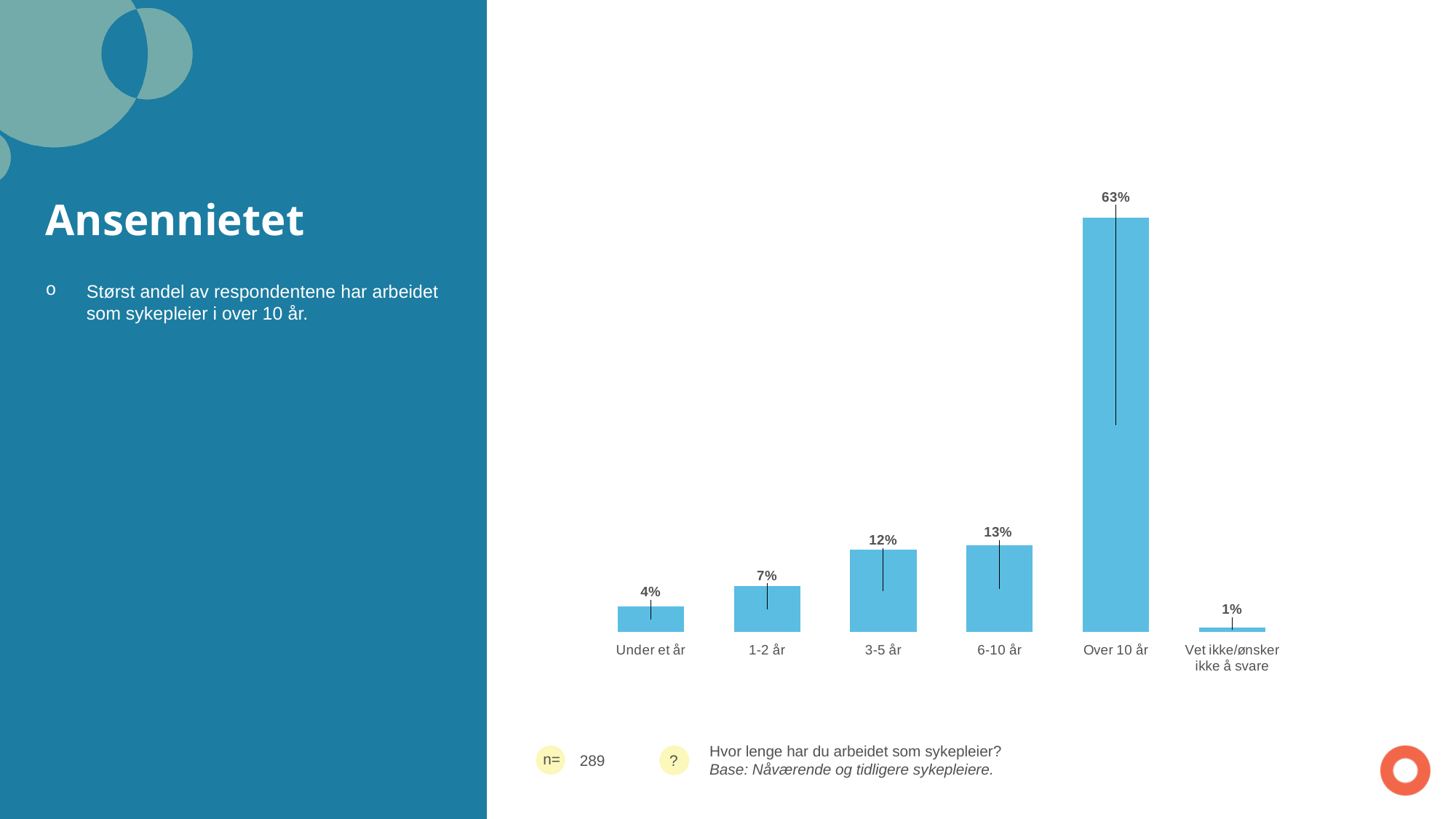
Which is larger, the value for '6-10 år' or the value for '1-2 år'? 6-10 år What is the value for '3-5 år'? 12% Which category has the highest value? Over 10 år How many categories are shown on the x axis? 6 Which category has the lowest value? Vet ikke/ønsker ikke å svare What is the value for 'Under et år'? 4% What kind of chart is shown on the slide? bar chart What is the value for 'Vet ikke/ønsker ikke å svare'? 1% What is the value for 'Over 10 år'? 63% What is the difference between the values for 'Over 10 år' and '6-10 år'? 50% What is the sample size (n) shown below the chart? 289 What is the difference between the values for '1-2 år' and 'Under et år'? 3%